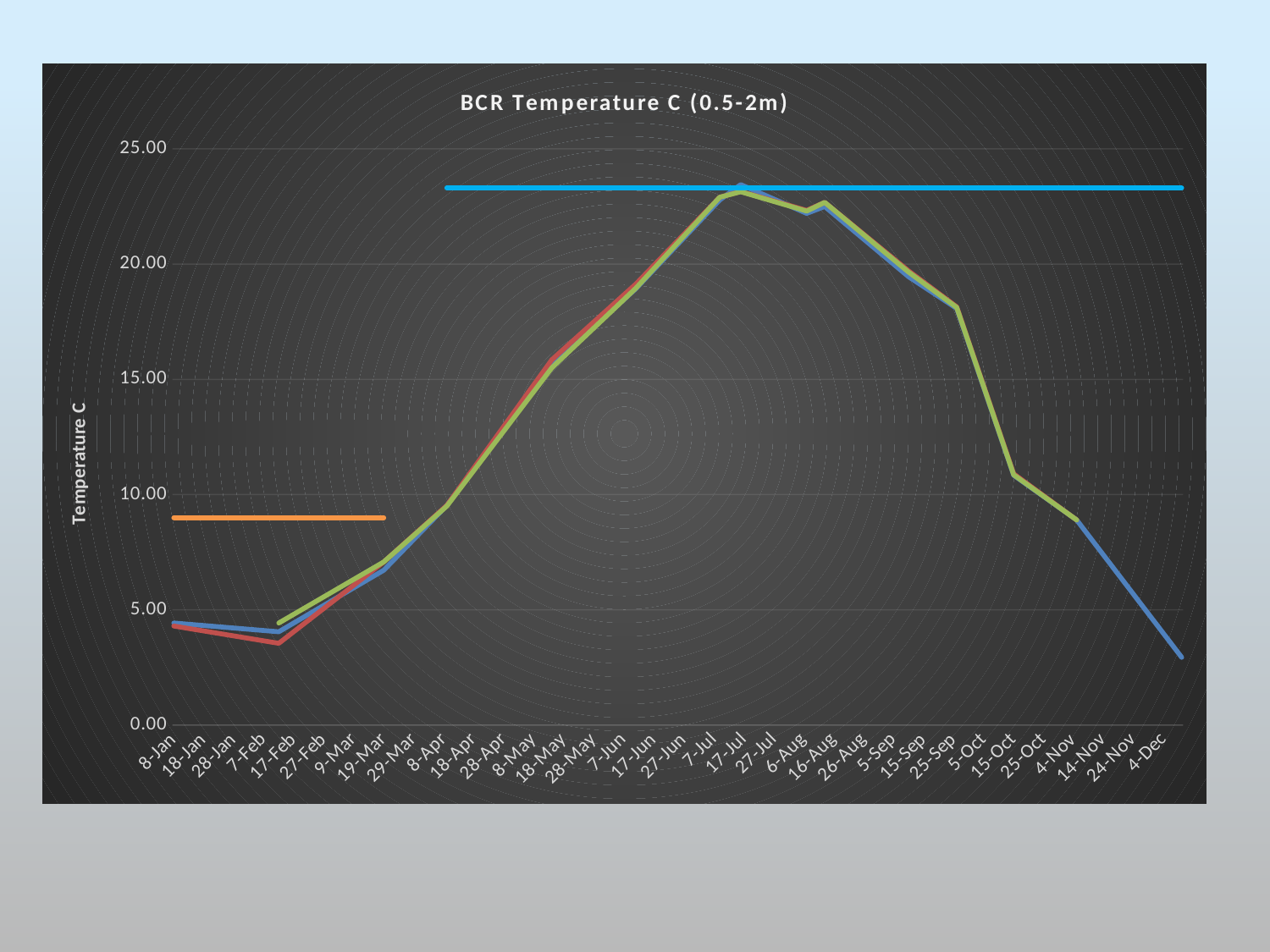
Is the value of the blue line at 8-Jan greater or less than 5.00? less Is the value of the blue line at 4-Dec greater or less than 5.00? less What kind of chart is shown on the slide? line chart Does the blue line rise or fall between 17-Jul and 4-Dec? fall Is the value of the blue line at 25-Sep greater or less than 15.00? greater At which date does the blue line reach its highest value? 17-Jul What is the title of the chart? BCR Temperature C (0.5-2m) What is the label on the vertical axis of the chart? Temperature C Does the blue line rise or fall between 17-Feb and 17-Jul? rise